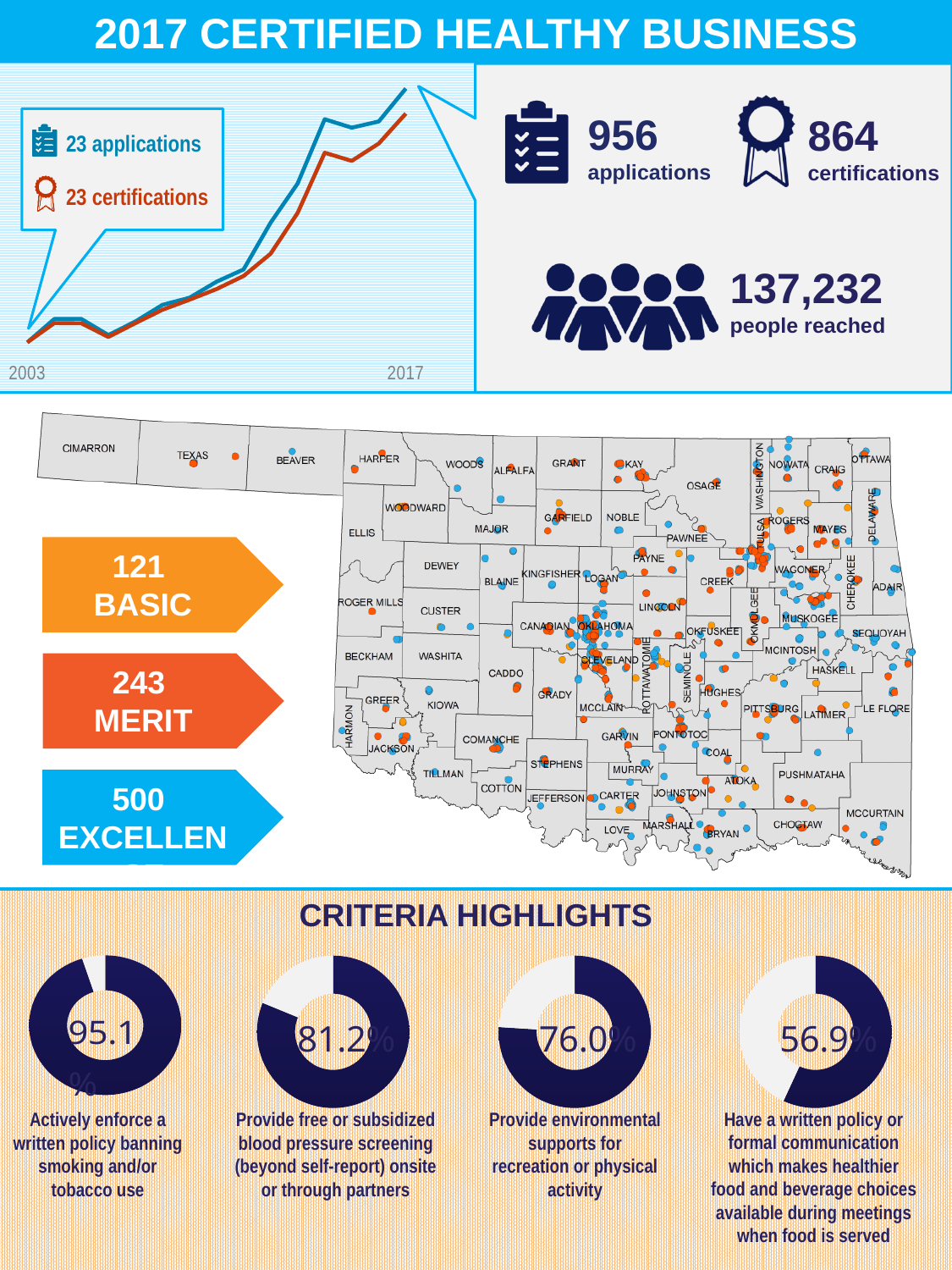
According to the callout on the top-left line chart, how many applications were there in 2003? 23 applications In the top-left line chart, which line is higher at 2017, applications (blue) or certifications (orange)? Applications (blue) In the Criteria Highlights section, what percentage actively enforce a written policy banning smoking and/or tobacco use? 95.1% In the top-left line chart, do the values generally rise or fall from 2003 to 2017? Rise What kind of charts are used in the Criteria Highlights section? Donut (pie) charts How many donut charts are shown in the Criteria Highlights section? 4 In the Criteria Highlights section, which criterion has the lowest percentage? Have a written policy or formal communication which makes healthier food and beverage choices available during meetings when food is served (56.9%) In the top-left line chart, how many lines (series) are plotted? 2 According to the callout on the top-left line chart, how many certifications were there in 2003? 23 certifications In the Criteria Highlights section, what is the difference between the highest percentage (95.1%) and the lowest percentage (56.9%)? 38.2 percentage points What kind of chart is shown in the top-left panel spanning 2003 to 2017? Line chart In the Criteria Highlights section, what percentage provide free or subsidized blood pressure screening? 81.2%